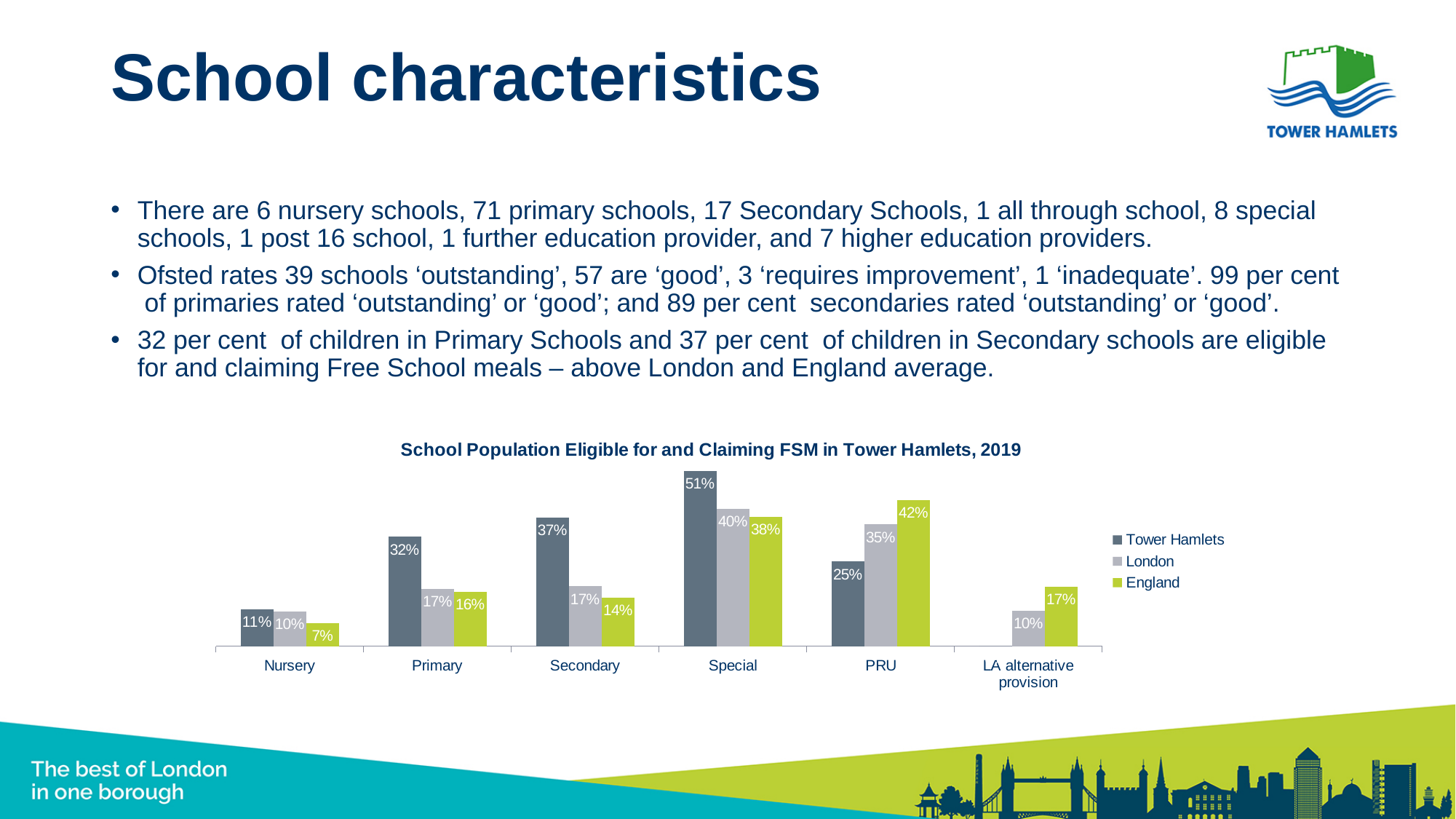
How many school categories are shown on the x axis? 6 What is the title of the chart? School Population Eligible for and Claiming FSM in Tower Hamlets, 2019 For PRU, which is larger: the Tower Hamlets value or the London value? London What is the difference between the Tower Hamlets and England values for Secondary schools? 23% Which category has the lowest England value? Nursery What is the England value for PRU? 42% What kind of chart is shown on the slide? Bar chart Which category has the highest Tower Hamlets value? Special What is the Tower Hamlets value for Special schools? 51% What is the England value for Nursery? 7% What is the London value for Primary schools? 17% How many series does the legend list? 3